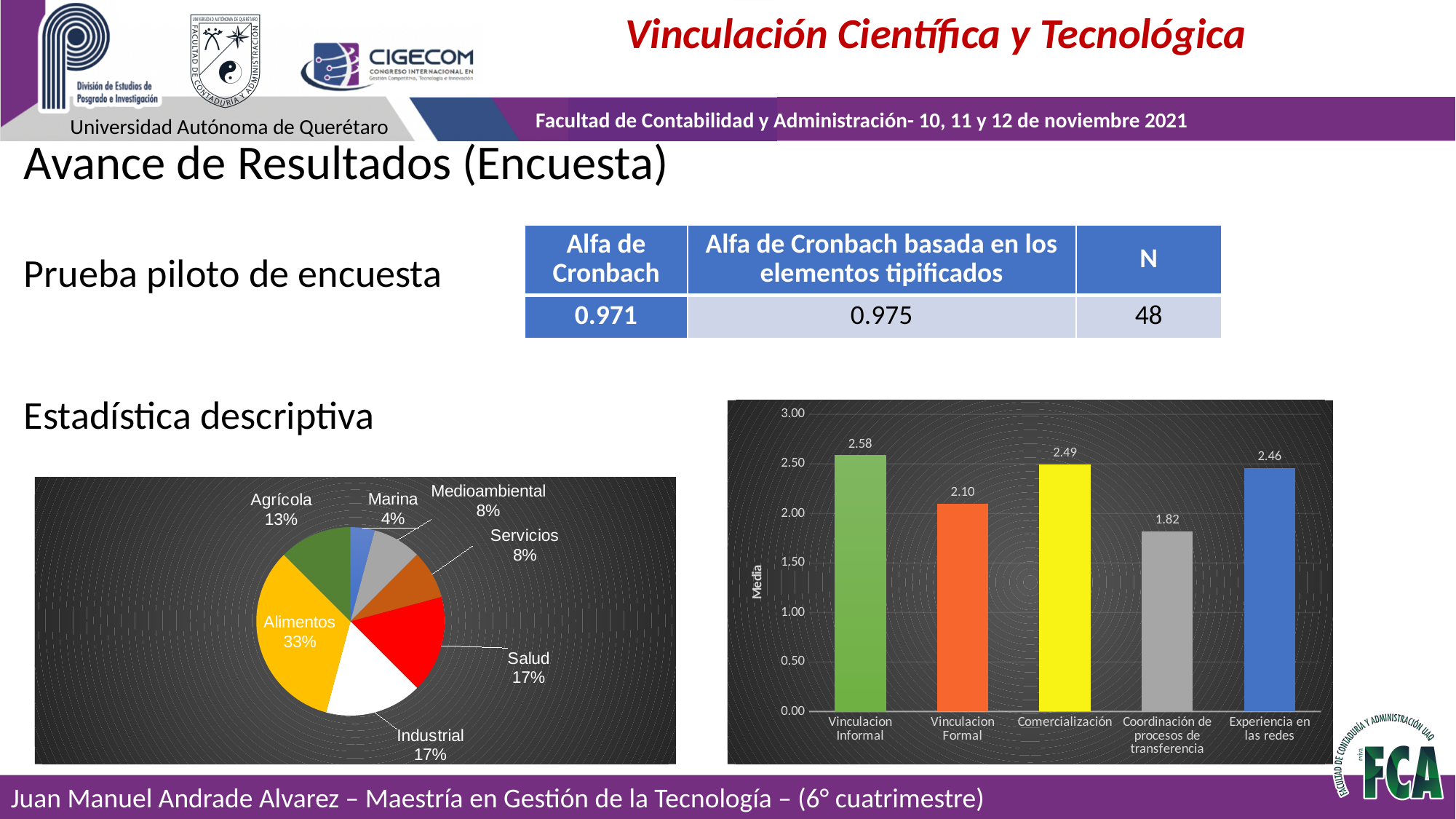
In the pie chart on the left, which sector has the largest share? Alimentos In the bar chart on the right, which category has the highest value? Vinculacion Informal What kind of chart is shown on the right side of the slide? Bar chart In the pie chart on the left, what share does Marina have? 4% In the pie chart on the left, what is the difference between the shares of Alimentos and Agrícola? 20% In the bar chart on the right, what is the difference between Vinculacion Informal and Vinculacion Formal? 0.48 In the bar chart on the right, what is the value for Coordinación de procesos de transferencia? 1.82 In the pie chart on the left, which sector has the smallest share? Marina In the pie chart on the left, what share does Alimentos have? 33% In the bar chart on the right, which category has the lowest value? Coordinación de procesos de transferencia In the pie chart on the left, how many sectors are shown? 7 In the bar chart on the right, what is the value for Vinculacion Formal? 2.10